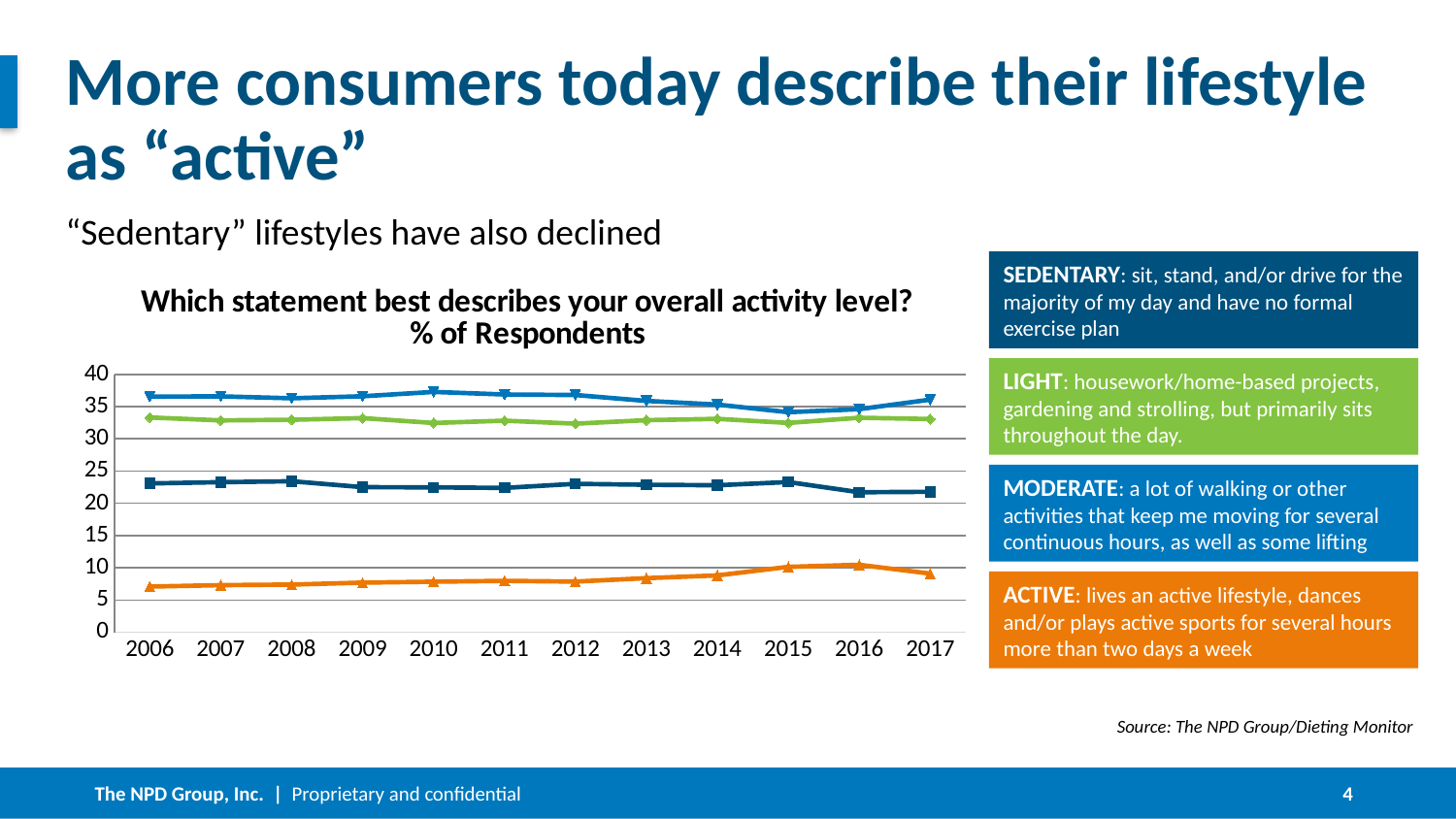
Does the Active line rise or fall from 2006 to 2016? rise What kind of chart is shown on the slide? line chart Is the value for Moderate in 2010 greater or less than 35? greater Is the value for Sedentary in 2006 greater or less than 20? greater In 2010, which is larger: the Moderate value or the Light value? Moderate How many years are plotted along the x axis of the chart? 12 What is the first year shown on the x axis of the chart? 2006 Is the value for Active in 2006 greater or less than 10? less How many lines (series) are plotted in the chart? 4 Which activity level has the lowest line across the chart? Active Which activity level has the highest line across the chart? Moderate